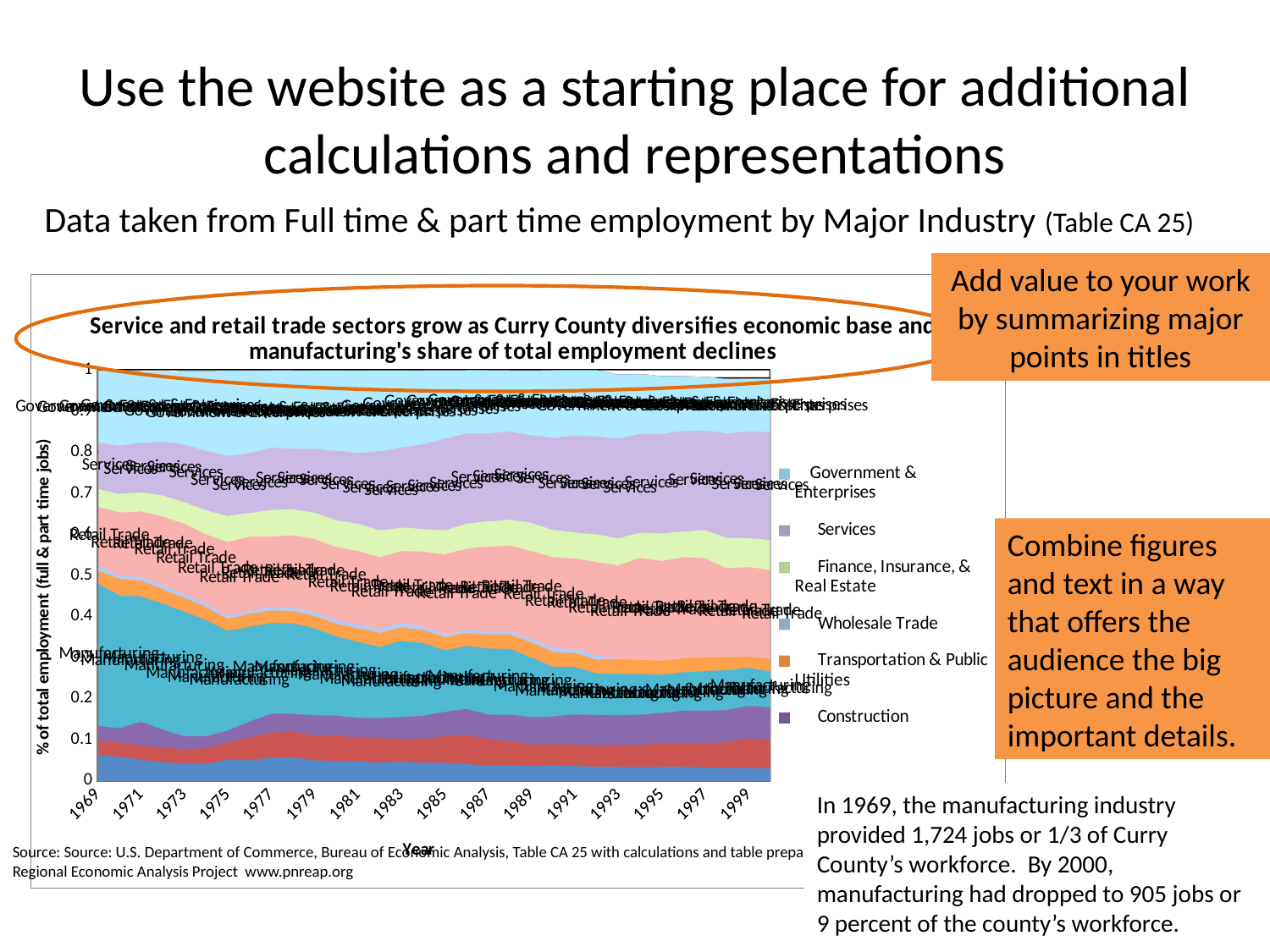
What is the title of the chart? Service and retail trade sectors grow as Curry County diversifies economic base and manufacturing's share of total employment declines What is the highest value shown on the y axis of the chart? 1 Does the Manufacturing share of total employment rise or fall from 1969 to 1999? Fall Is the Construction share of total employment in 1969 greater or less than 0.1? less How many year labels are shown along the x axis of the chart? 16 What is the last year shown on the x axis of the chart? 1999 What is the label of the x axis of the chart? Year What kind of chart is shown on the slide? Stacked area chart Does the Services share of total employment rise or fall from 1969 to 1999? Rise What is the first year shown on the x axis of the chart? 1969